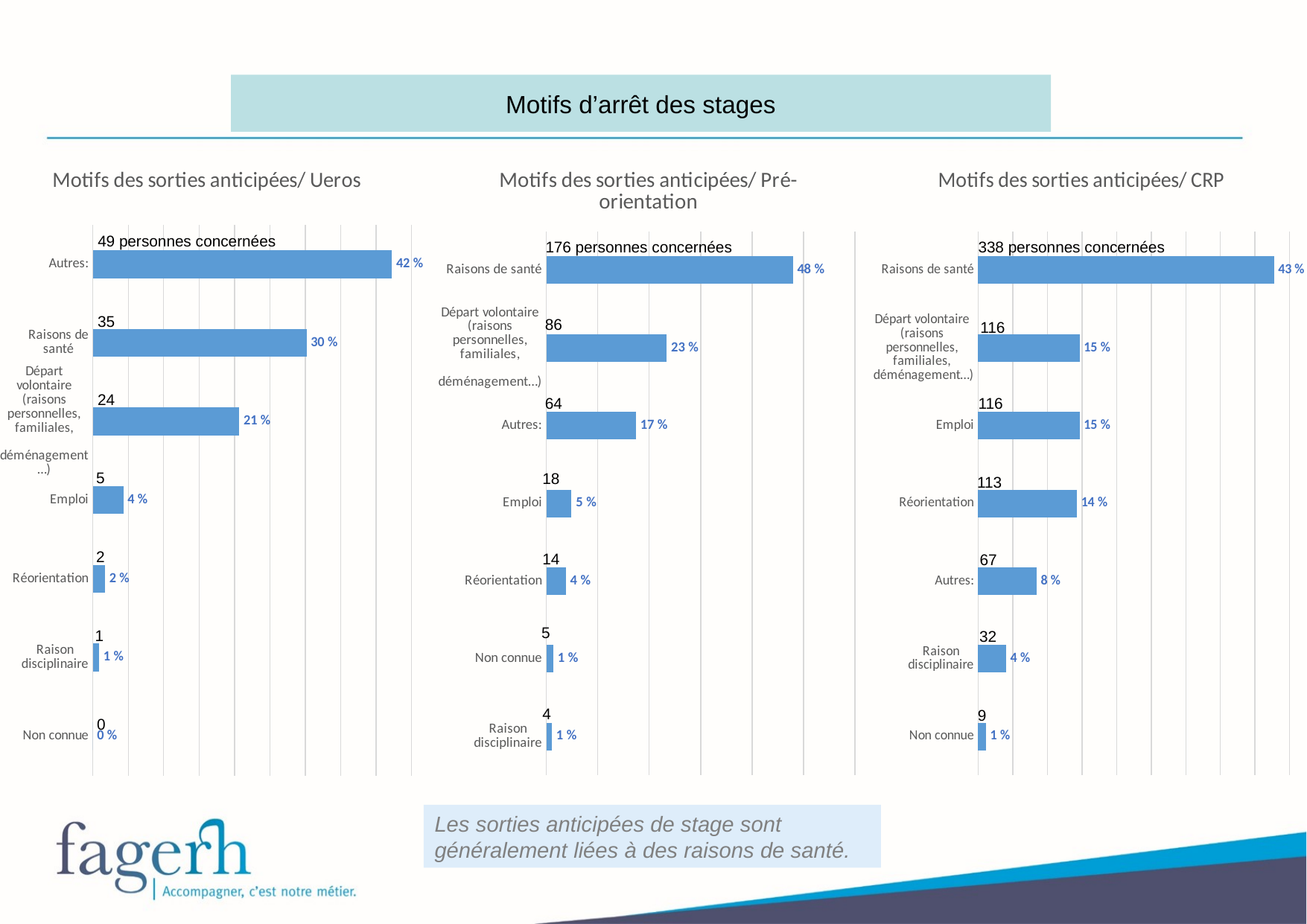
In the 'Motifs des sorties anticipées/ Pré-orientation' chart, how many people are counted for 'Autres:'? 64 In the 'Motifs des sorties anticipées/ Ueros' chart, what percentage is shown for 'Raisons de santé'? 30 % What type of chart is used for 'Motifs des sorties anticipées/ Ueros'? Bar chart In the 'Motifs des sorties anticipées/ CRP' chart, how many people are counted for 'Réorientation'? 113 What is the title of the slide? Motifs d’arrêt des stages In the 'Motifs des sorties anticipées/ CRP' chart, which has the larger count, 'Autres:' or 'Raison disciplinaire'? Autres: In the 'Motifs des sorties anticipées/ Pré-orientation' chart, which category has the lowest count? Raison disciplinaire How many categories are shown in the 'Motifs des sorties anticipées/ CRP' chart? 7 In the 'Motifs des sorties anticipées/ Pré-orientation' chart, what percentage is shown for 'Départ volontaire'? 23 % In the 'Motifs des sorties anticipées/ CRP' chart, what is the difference in count between 'Raisons de santé' and 'Emploi'? 222 In the 'Motifs des sorties anticipées/ Ueros' chart, how many people are counted for 'Emploi'? 5 In the 'Motifs des sorties anticipées/ Ueros' chart, which category has the highest value? Autres: